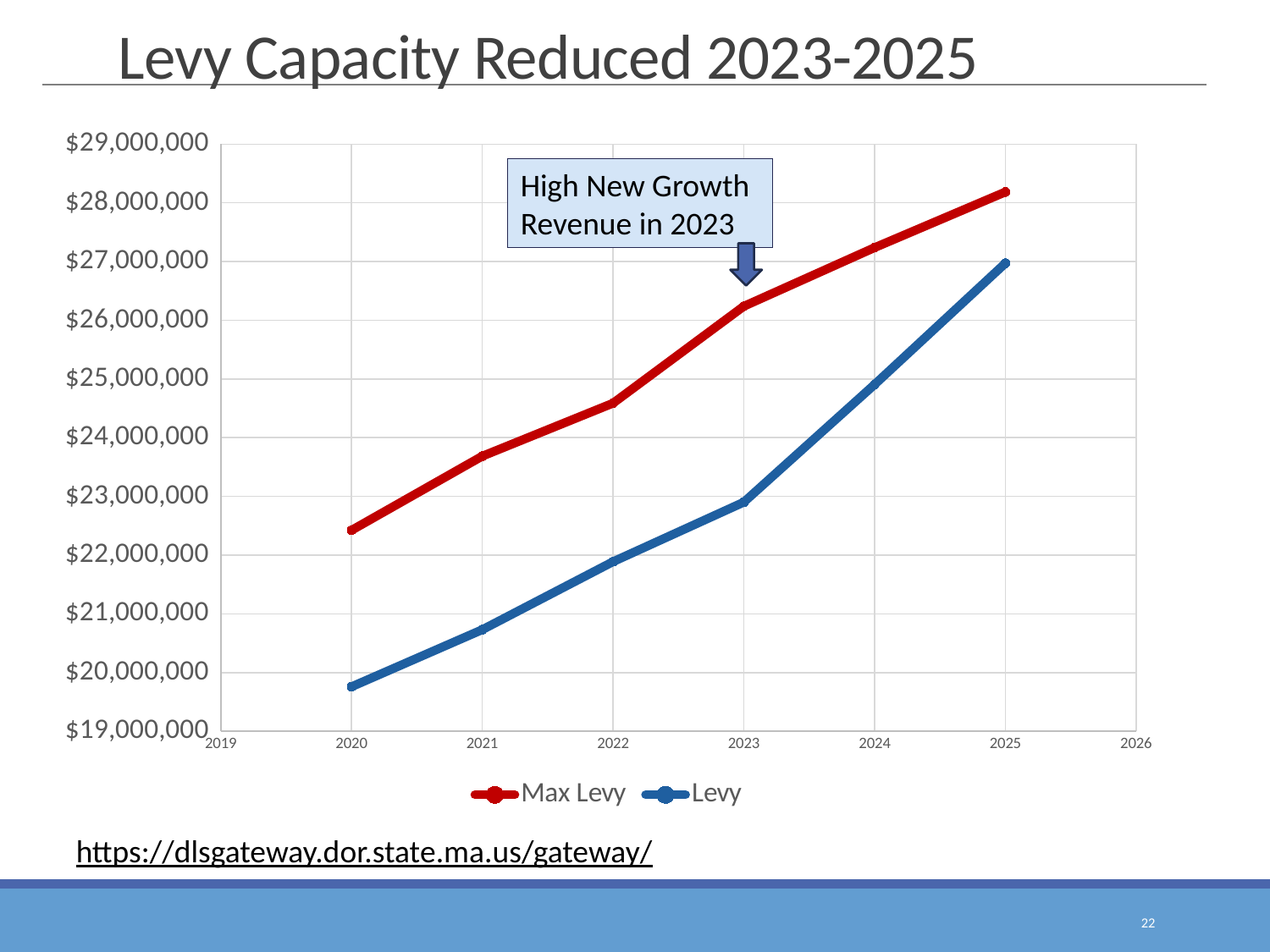
Is the Levy value for 2020 greater or less than $20,000,000? less In which year is the Max Levy value highest? 2025 How many series does the legend list? 2 Is the Max Levy value for 2020 greater or less than $22,000,000? greater What kind of chart is shown on the slide? Line chart In which year is the Levy value lowest? 2020 Does the Levy series rise or fall from 2020 to 2025? Rise Which series is higher in 2023, Max Levy or Levy? Max Levy What does the annotation box on the chart say? High New Growth Revenue in 2023 Is the Max Levy value for 2023 greater or less than $26,000,000? greater What is the title of the slide containing the chart? Levy Capacity Reduced 2023-2025 How many data points are plotted for the Max Levy series? 6